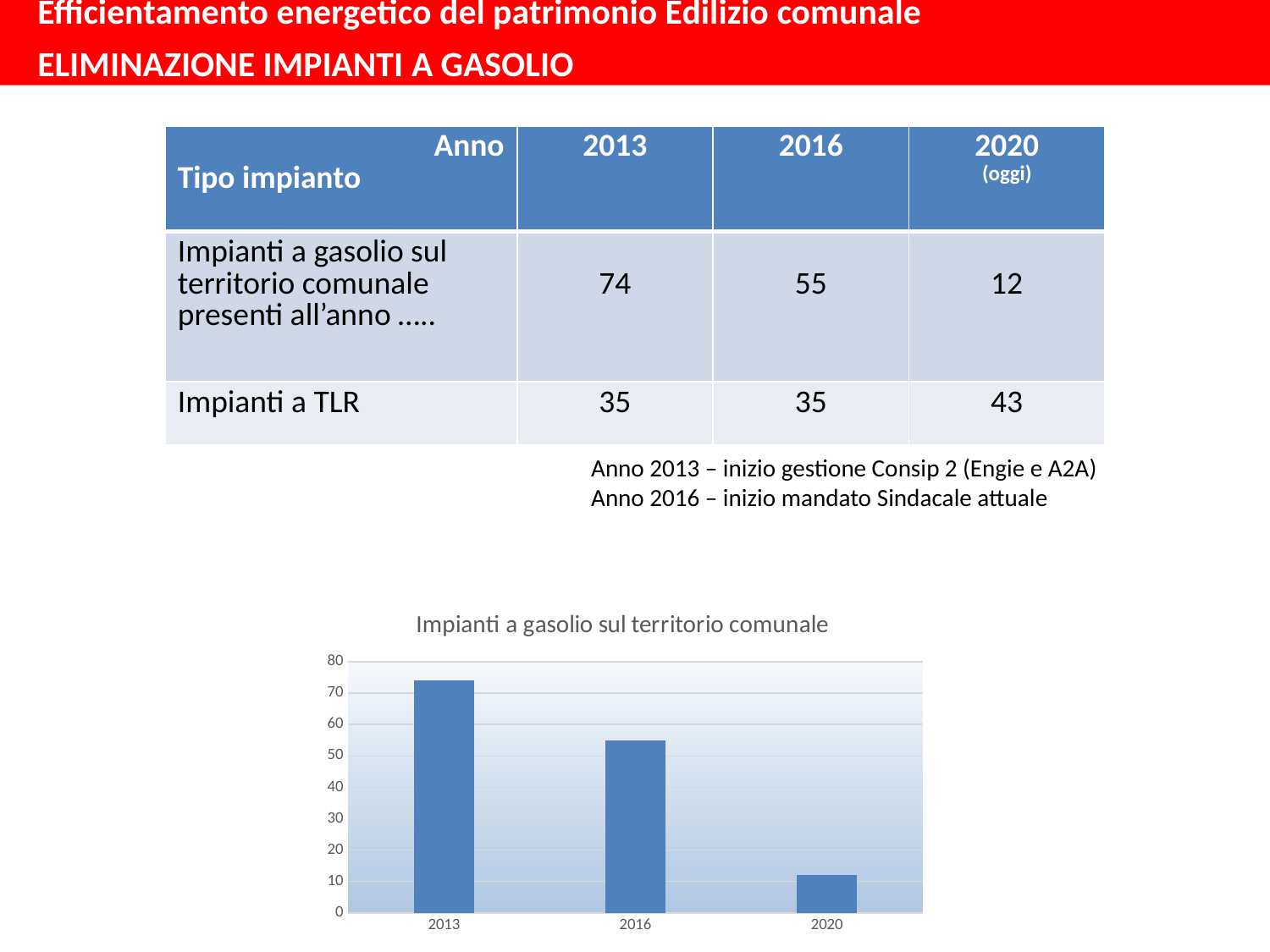
What is the title of the chart? Impianti a gasolio sul territorio comunale Which year has the highest bar in the chart? 2013 What kind of chart is shown on the slide? bar chart According to the slide, what is the difference between the number of impianti a gasolio in 2013 and in 2020? 62 Do the values in the chart rise or fall from 2013 to 2020? fall How many years are shown on the x axis of the chart? 3 According to the slide, how many impianti a gasolio were on the territorio comunale in 2013? 74 Is the value for 2013 in the chart greater or less than 70? greater Which is larger in the chart, the value for 2016 or the value for 2020? 2016 Is the value for 2016 in the chart greater or less than 60? less Which year has the lowest bar in the chart? 2020 Is the value for 2020 in the chart greater or less than 20? less